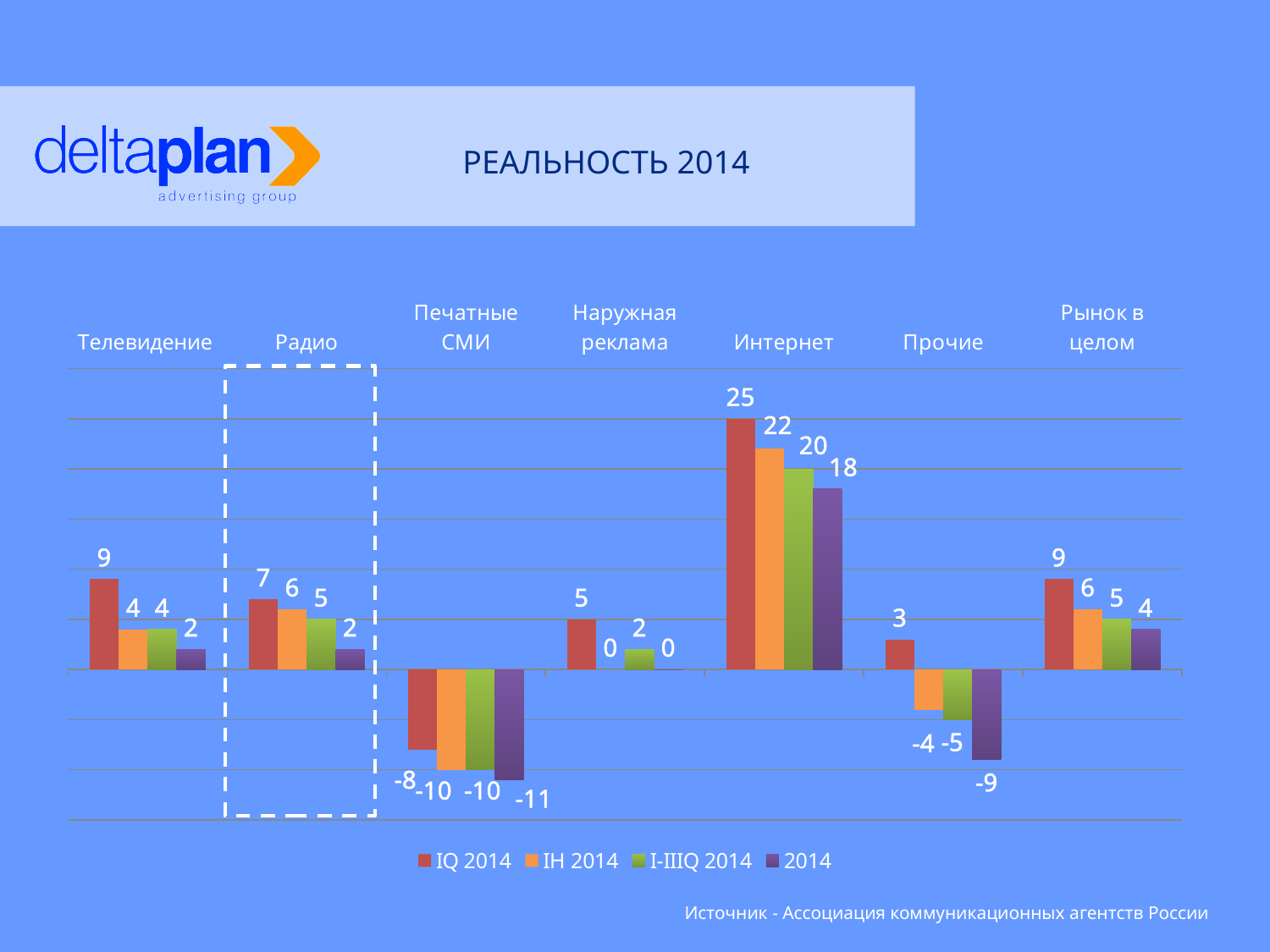
What is the difference between the IQ 2014 and 2014 values for Интернет? 7 What kind of chart is shown on the slide? Bar chart Which is larger: the 2014 value for Телевидение or the 2014 value for Рынок в целом? Рынок в целом Which category is highlighted with a dashed outline? Радио What is the value for Печатные СМИ in the 2014 series? -11 How many series does the legend list? 4 What is the value for Прочие in the I-IIIQ 2014 series? -5 What is the value for Интернет in the IQ 2014 series? 25 Which category has the highest value in the 2014 series? Интернет What is the value for Радио in the IH 2014 series? 6 Which category has the lowest value in the IQ 2014 series? Печатные СМИ How many categories are shown on the x axis? 7